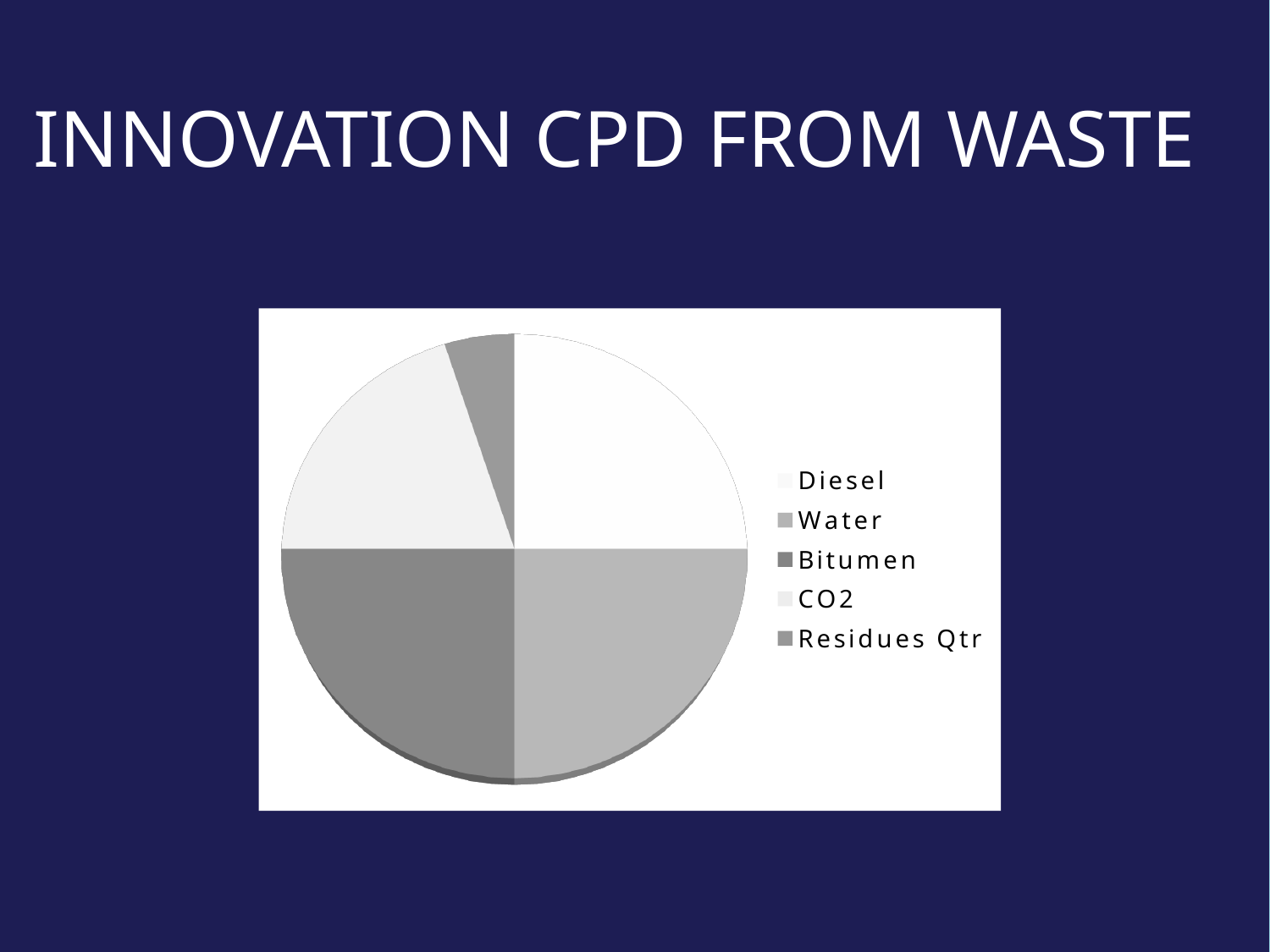
Which category is listed last in the pie chart's legend? Residues Qtr What kind of chart is shown on the slide? pie chart How many slices does the pie chart have? 5 Which category is listed first in the pie chart's legend? Diesel Which slice is larger, CO2 or Residues Qtr? CO2 Which category has the smallest slice in the pie chart? Residues Qtr Which slice is larger, Bitumen or Residues Qtr? Bitumen Which slice is larger, Water or Residues Qtr? Water